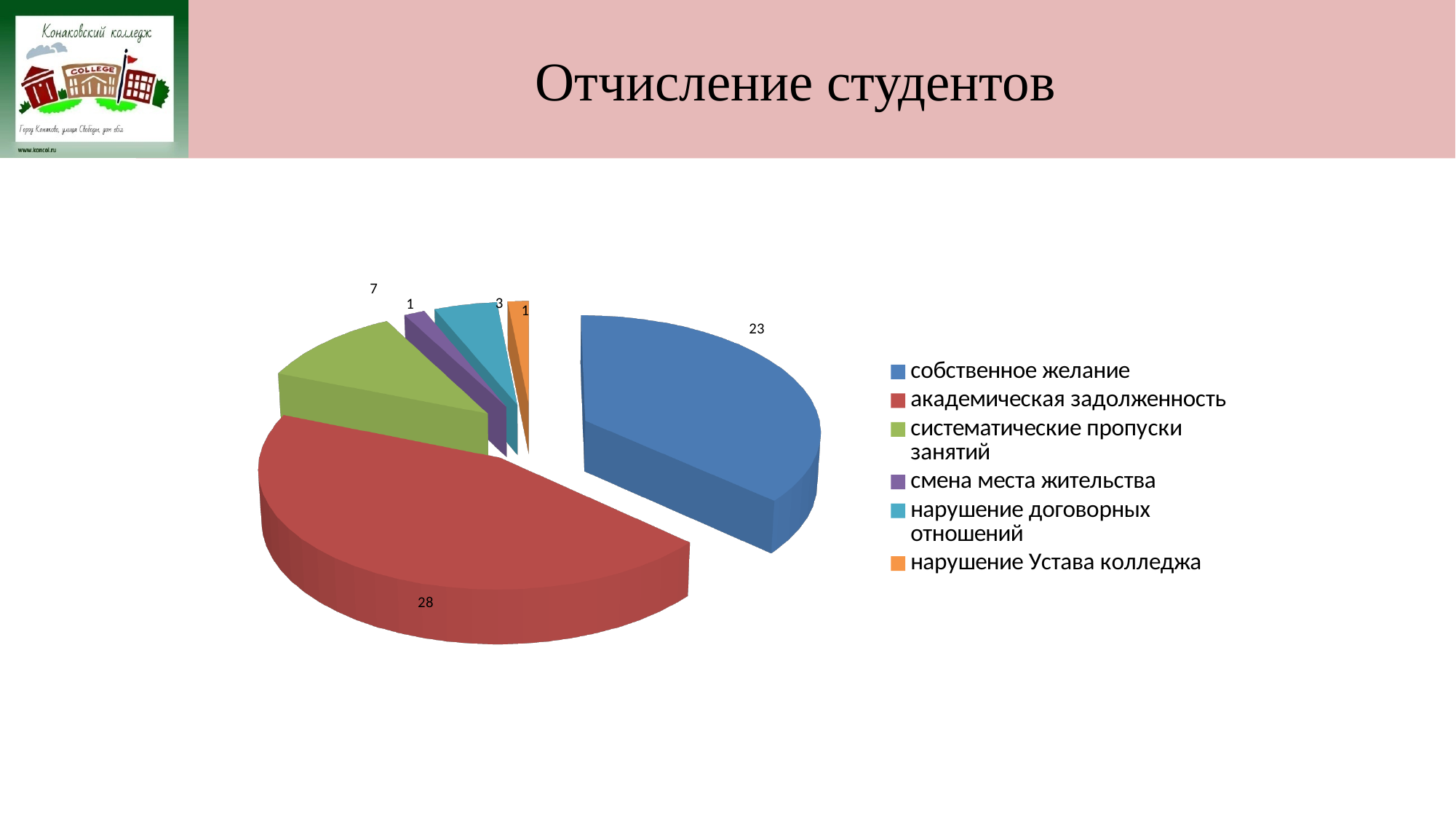
What is the difference between the values for "академическая задолженность" and "собственное желание"? 5 What is the value for "собственное желание"? 23 How many categories does the pie chart have? 6 What is the value for "систематические пропуски занятий"? 7 What type of chart is shown on the slide? pie chart What is the title of the slide containing the chart? Отчисление студентов Which is larger: "систематические пропуски занятий" or "нарушение договорных отношений"? систематические пропуски занятий What is the value for "нарушение договорных отношений"? 3 What is the total of all slices in the pie chart? 63 What is the value for "смена места жительства"? 1 Which category has the largest slice? академическая задолженность What is the value for "академическая задолженность"? 28